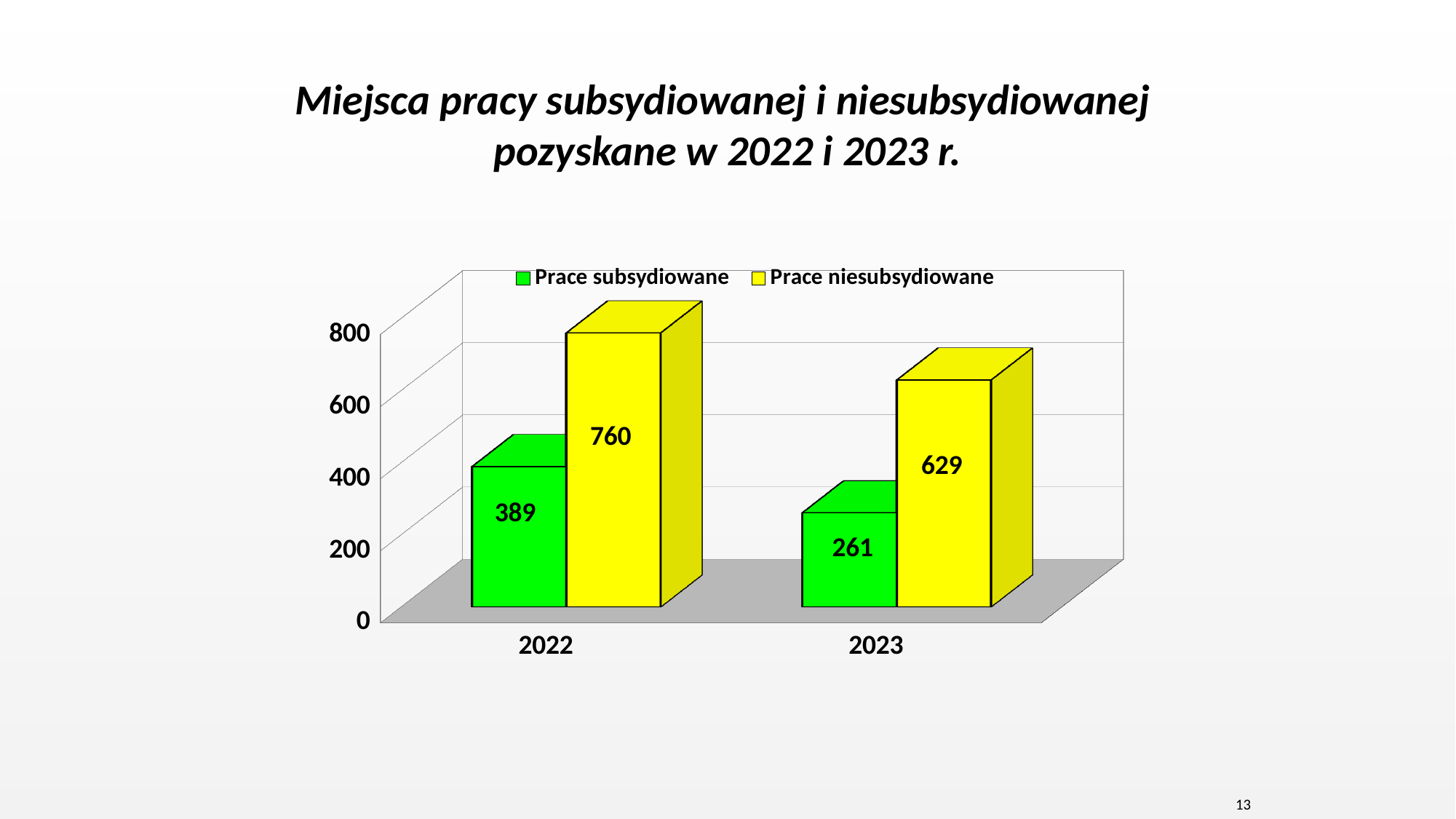
By how much did Prace subsydiowane fall from 2022 to 2023? 128 Do the values for Prace niesubsydiowane rise or fall from 2022 to 2023? Fall What is the value for Prace niesubsydiowane in 2022? 760 Which year has the lowest value for Prace subsydiowane? 2023 What is the difference between Prace niesubsydiowane and Prace subsydiowane in 2022? 371 Which is larger in 2023: Prace subsydiowane or Prace niesubsydiowane? Prace niesubsydiowane What is the value for Prace niesubsydiowane in 2023? 629 How many series does the legend list? 2 Which year has the highest value for Prace niesubsydiowane? 2022 What is the value for Prace subsydiowane in 2022? 389 What is the value for Prace subsydiowane in 2023? 261 What kind of chart is shown on the slide? Bar chart